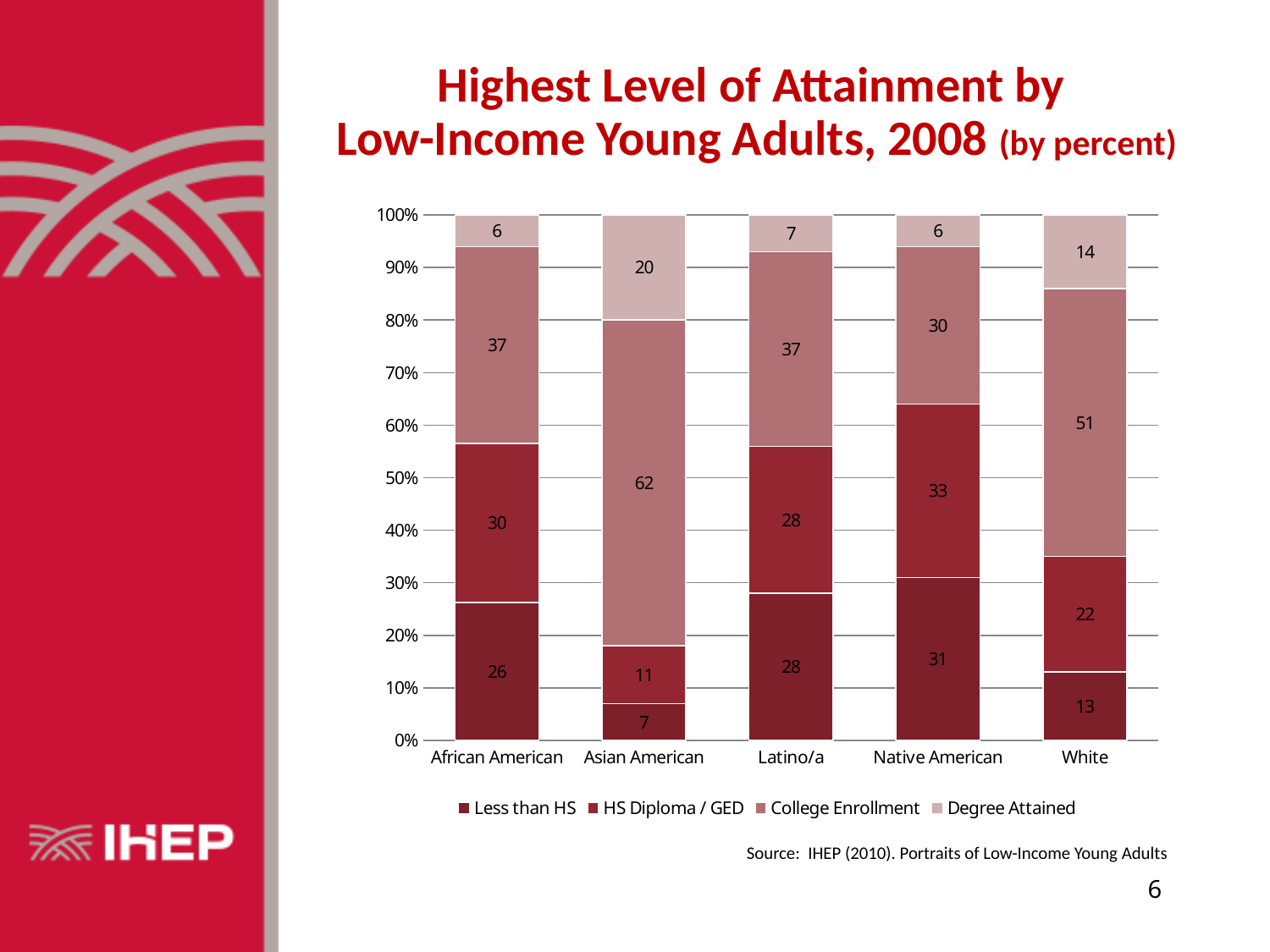
Which is larger, the HS Diploma / GED value for Native American or for African American? Native American Which group has the highest Degree Attained value? Asian American What is the title of the chart? Highest Level of Attainment by Low-Income Young Adults, 2008 (by percent) What is the difference between the College Enrollment values for White and African American? 14 What is the Degree Attained value for Asian American? 20 Which group has the lowest Less than HS value? Asian American How many series does the legend list? 4 What is the HS Diploma / GED value for Latino/a? 28 What is the College Enrollment value for White? 51 How many groups are shown on the x axis? 5 What kind of chart is shown on the slide? Stacked bar chart What is the Less than HS value for Asian American? 7